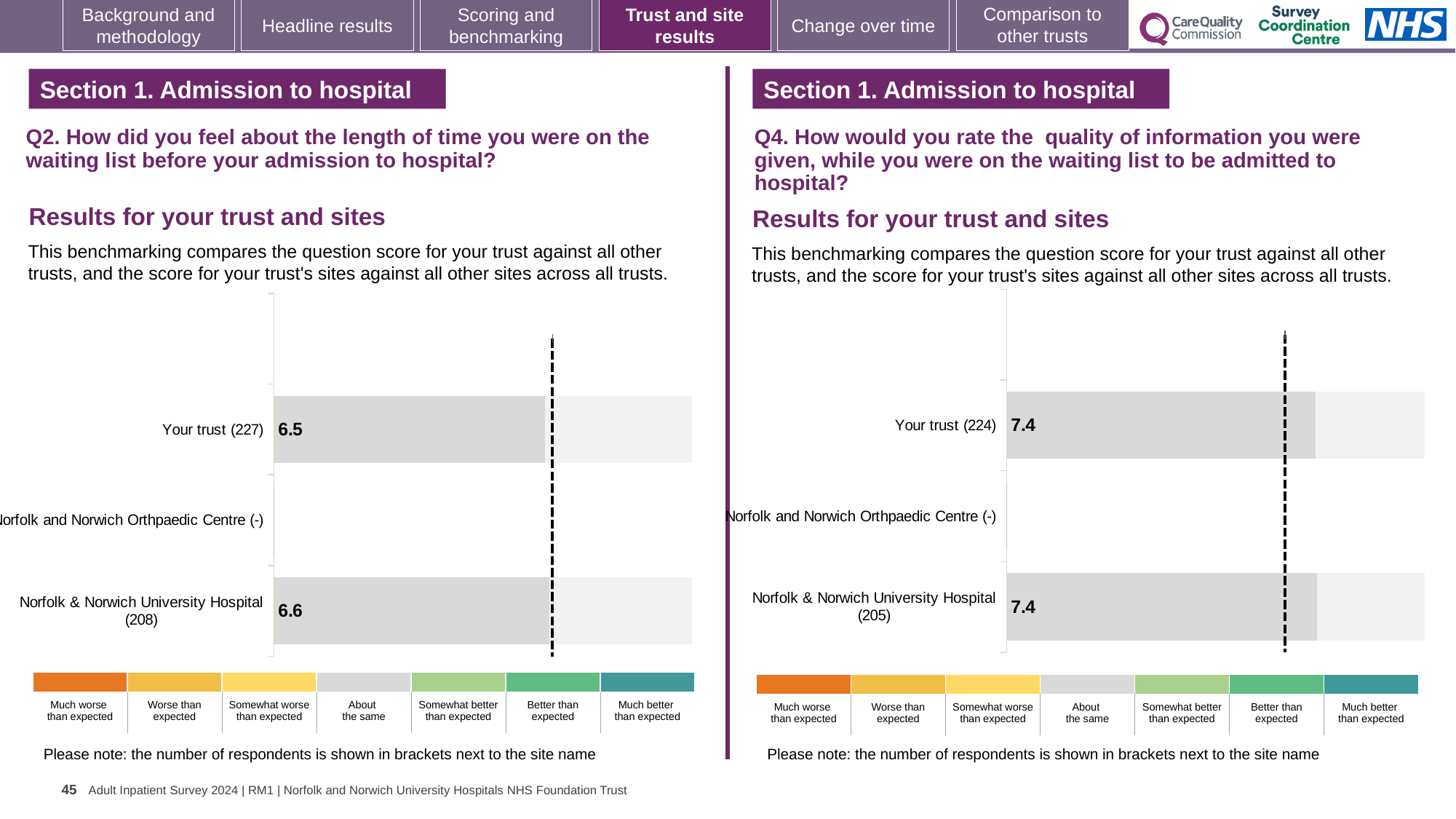
In the left chart (Q2), what is the score for Norfolk & Norwich University Hospital (208)? 6.6 What kind of chart is the right chart (Q4)? Bar chart In the left chart (Q2), what is the difference between the score for Norfolk & Norwich University Hospital (208) and the score for Your trust (227)? 0.1 In the right chart (Q4), how many respondents are shown in brackets for Your trust? 224 In the left chart (Q2), what is the score for Your trust (227)? 6.5 In the right chart (Q4), what is the score for Your trust (224)? 7.4 In the left chart (Q2), which category has the highest score? Norfolk & Norwich University Hospital (208) In the left chart (Q2), which has the higher score: Your trust (227) or Norfolk & Norwich University Hospital (208)? Norfolk & Norwich University Hospital (208) In the left chart (Q2), which category has no bar plotted? Norfolk and Norwich Orthpaedic Centre (-) How many categories are listed on the y axis of the left chart (Q2)? 3 In the right chart (Q4), what is the score for Norfolk & Norwich University Hospital (205)? 7.4 In the right chart (Q4), what is the difference between the score for Your trust (224) and the score for Norfolk & Norwich University Hospital (205)? 0